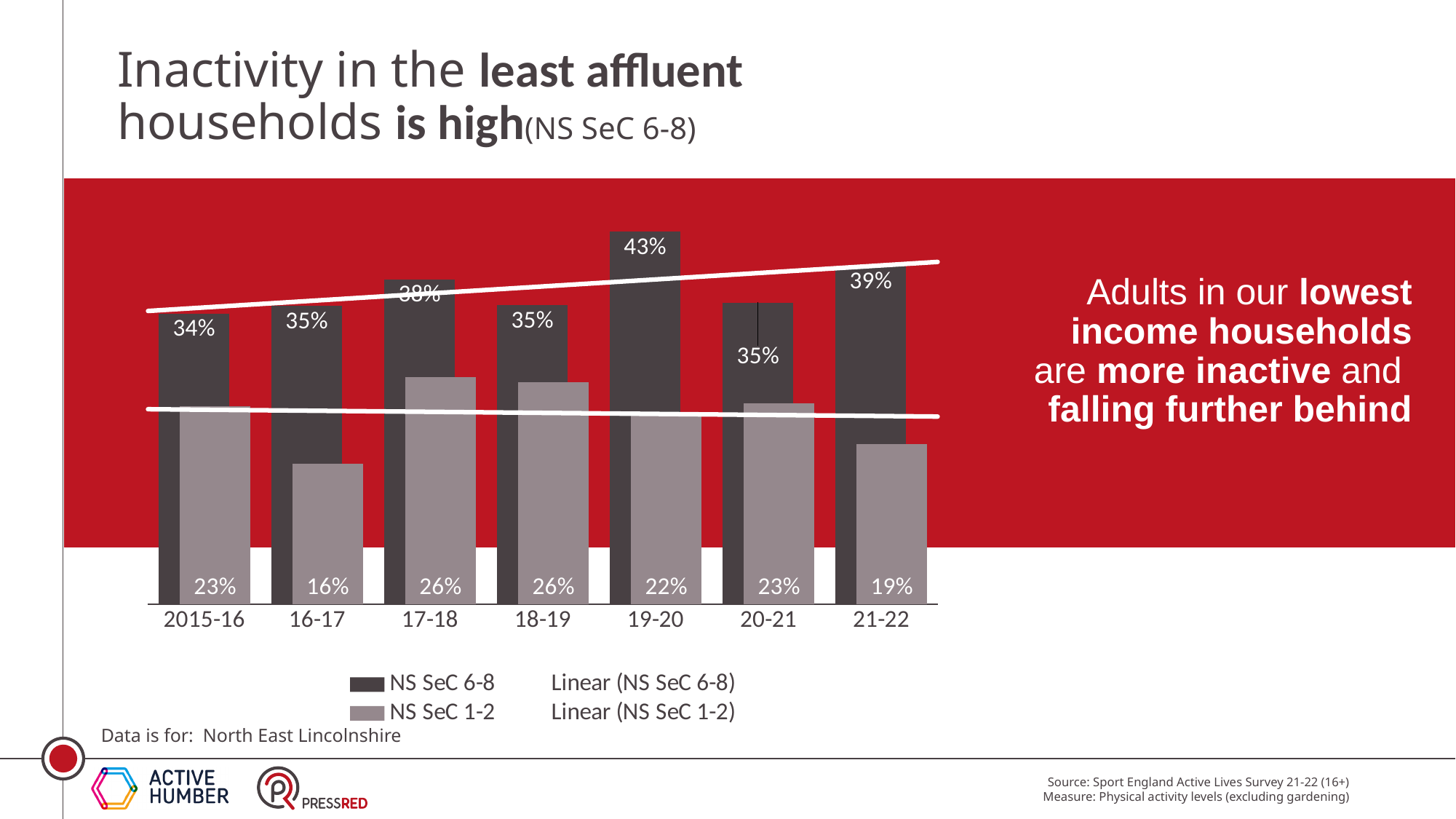
In which year is the NS SeC 6-8 value highest? 19-20 What is the value for NS SeC 1-2 in 2015-16? 23% How many entries does the legend list? 4 What is the value for NS SeC 1-2 in 16-17? 16% What kind of chart is shown on the slide? Bar chart What is the difference between the NS SeC 6-8 and NS SeC 1-2 values in 19-20? 21 percentage points Which is larger in 18-19: the NS SeC 6-8 value or the NS SeC 1-2 value? NS SeC 6-8 Does the linear trendline for NS SeC 6-8 rise or fall from 2015-16 to 21-22? Rises How many years are shown on the x axis? 7 In which year is the NS SeC 1-2 value lowest? 16-17 What is the value for NS SeC 6-8 in 19-20? 43% What is the value for NS SeC 6-8 in 21-22? 39%